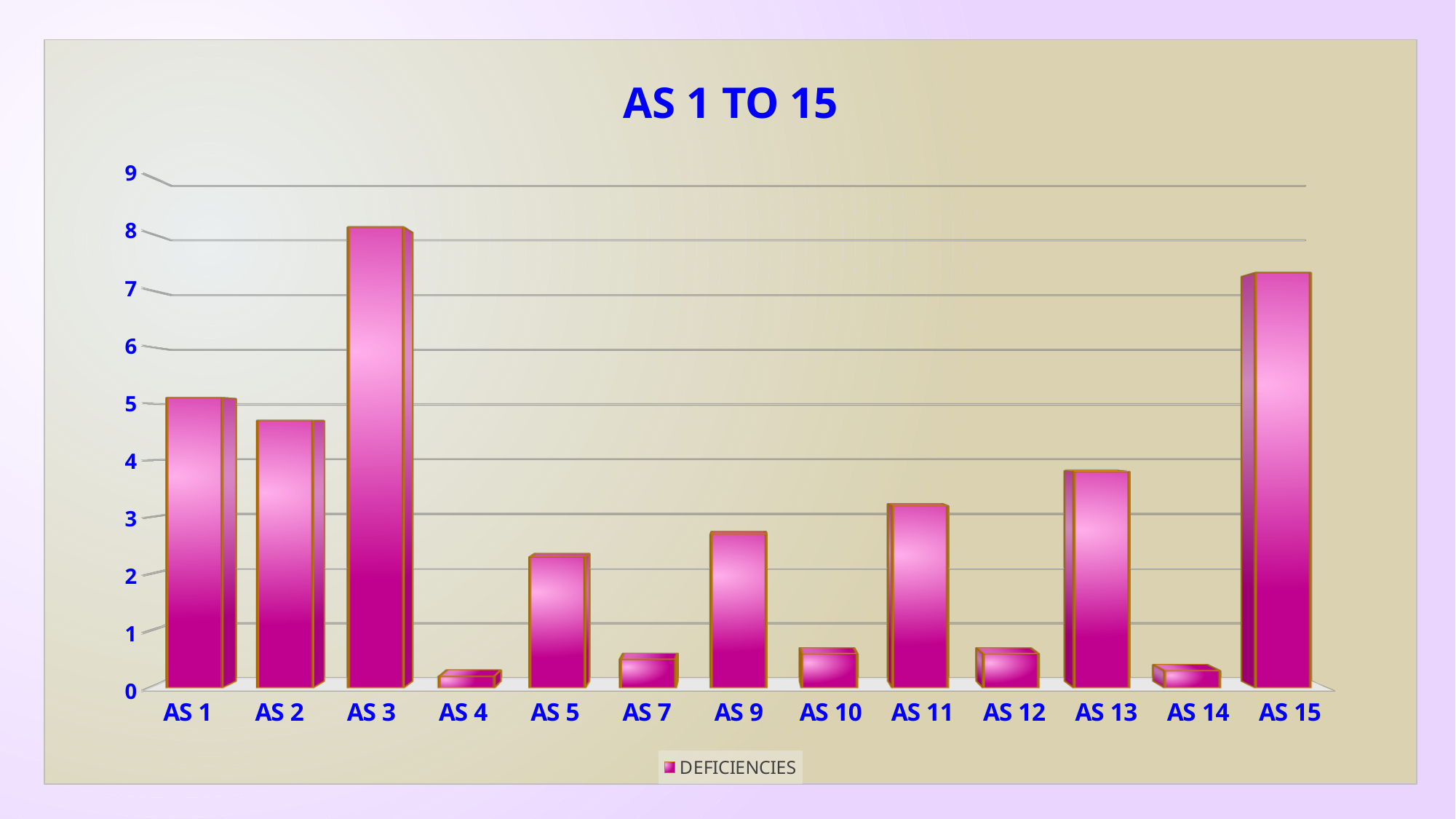
What type of chart is shown on the slide? Bar chart Is the value for AS 3 greater or less than 7? greater Which has the larger value, AS 1 or AS 5? AS 1 Is the value for AS 15 greater or less than 6? greater Is the value for AS 4 greater or less than 1? less Which has the larger value, AS 15 or AS 13? AS 15 Which category has the highest value? AS 3 What is the title of the chart? AS 1 TO 15 How many categories are shown on the x axis? 13 What series name does the legend list? DEFICIENCIES How many series does the legend list? 1